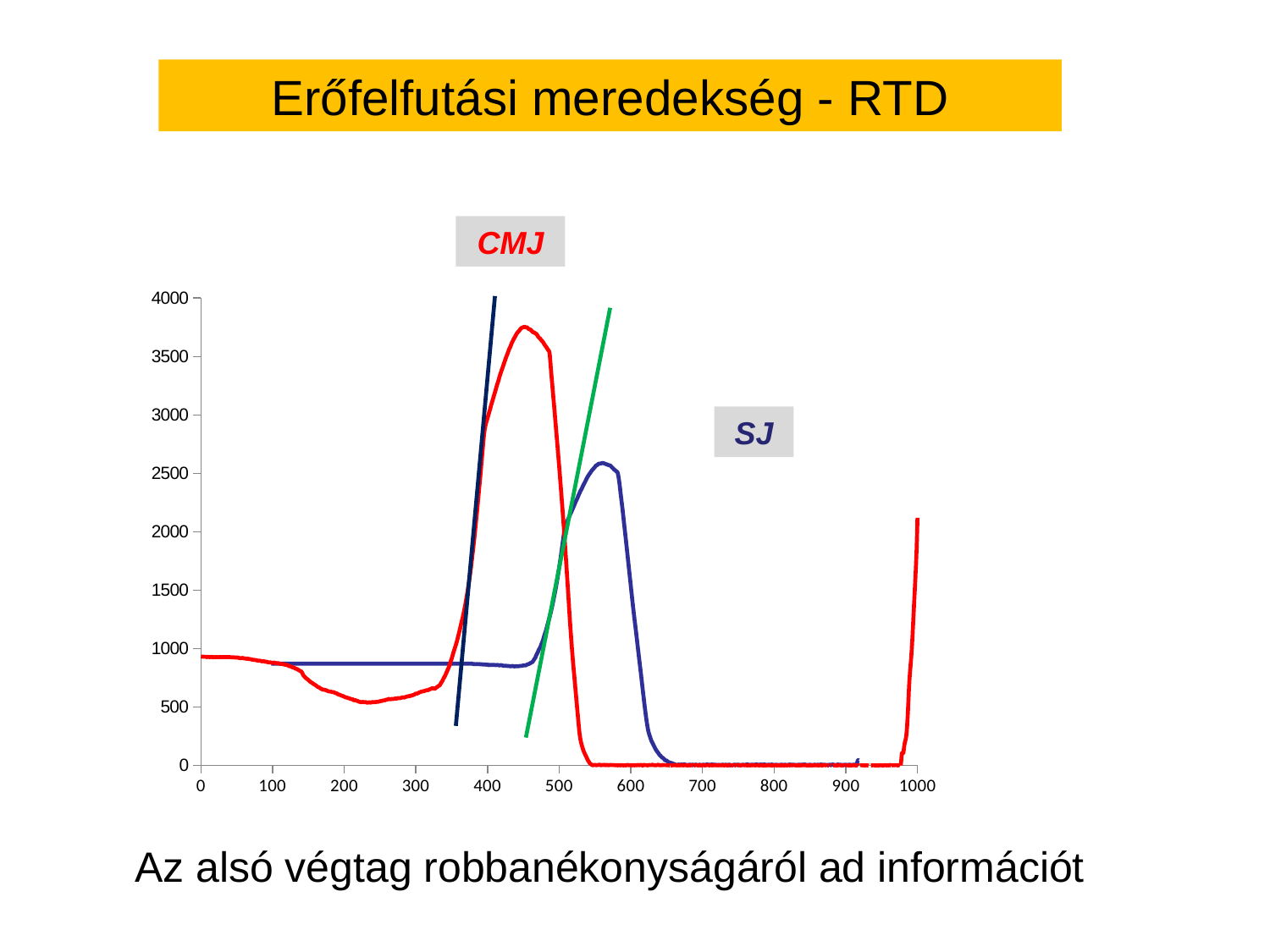
Which curve reaches the higher peak, CMJ or SJ? CMJ What kind of chart is shown on the slide? line chart Is the peak value of the CMJ curve greater or less than 3500? greater Is the peak value of the SJ curve greater or less than 3000? less Which curve reaches its peak earlier along the x axis, CMJ or SJ? CMJ What is the title shown above the chart? Erőfelfutási meredekség - RTD What colour is the CMJ curve? red How many labelled curves (CMJ and SJ) are plotted on the chart? 2 What is the highest tick value shown on the y axis? 4000 Does the CMJ curve rise or fall between x = 100 and x = 200? fall Is the value of the SJ curve at x = 800 greater or less than 500? less